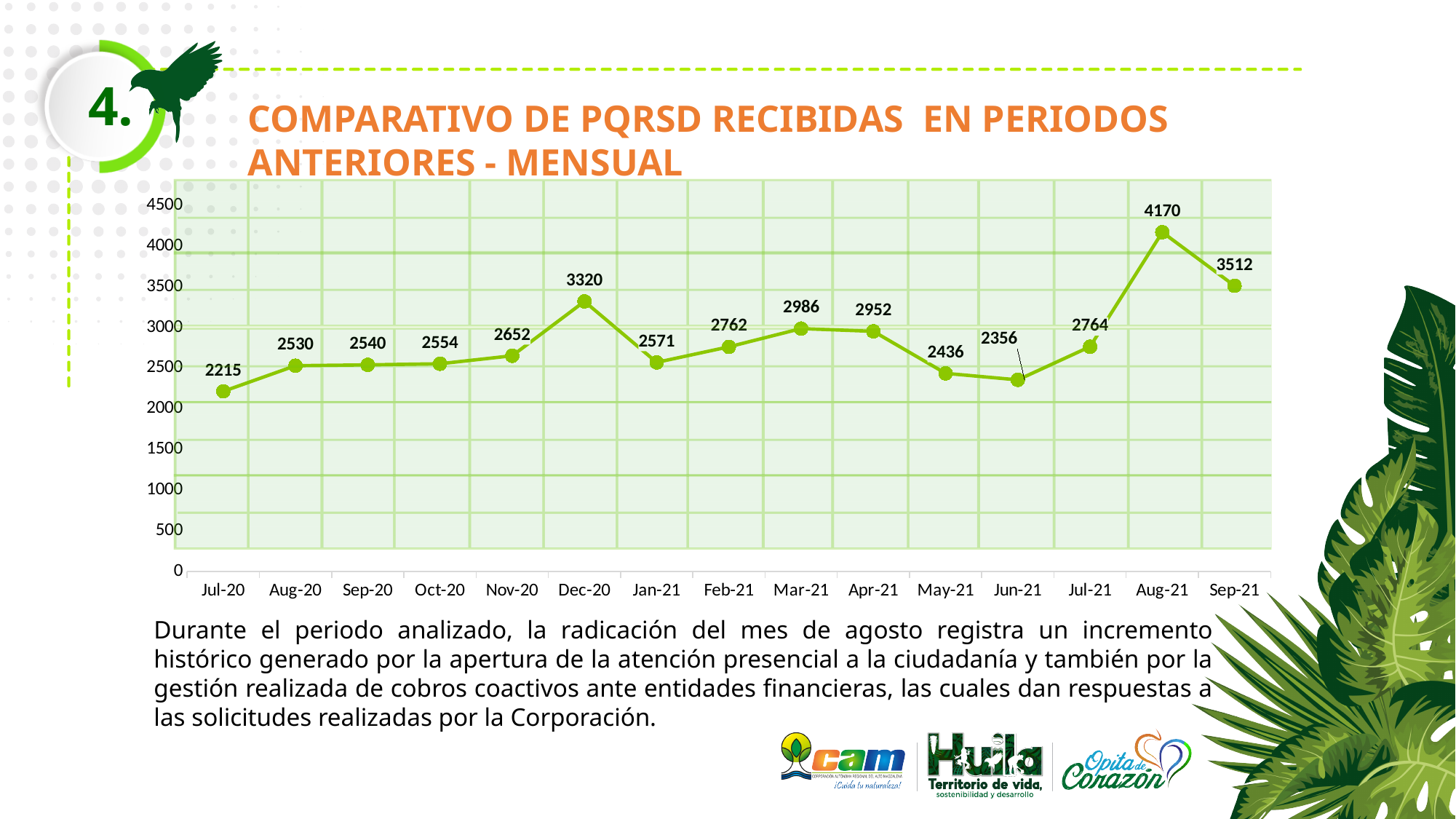
Which month has the highest value? Aug-21 What is the value for Dec-20? 3320 Which is larger, the value for Mar-21 or the value for Apr-21? Mar-21 What is the difference between the values for Aug-21 and Sep-21? 658 Which month has the lowest value? Jul-20 What type of chart is shown on the slide? line chart How many months are plotted on the x axis? 15 Do the values rise or fall from May-21 to Aug-21? rise What is the value for Jul-20? 2215 What is the value for Jun-21? 2356 What is the difference between the values for Dec-20 and Jan-21? 749 Is the value for Aug-21 greater or less than 4000? greater